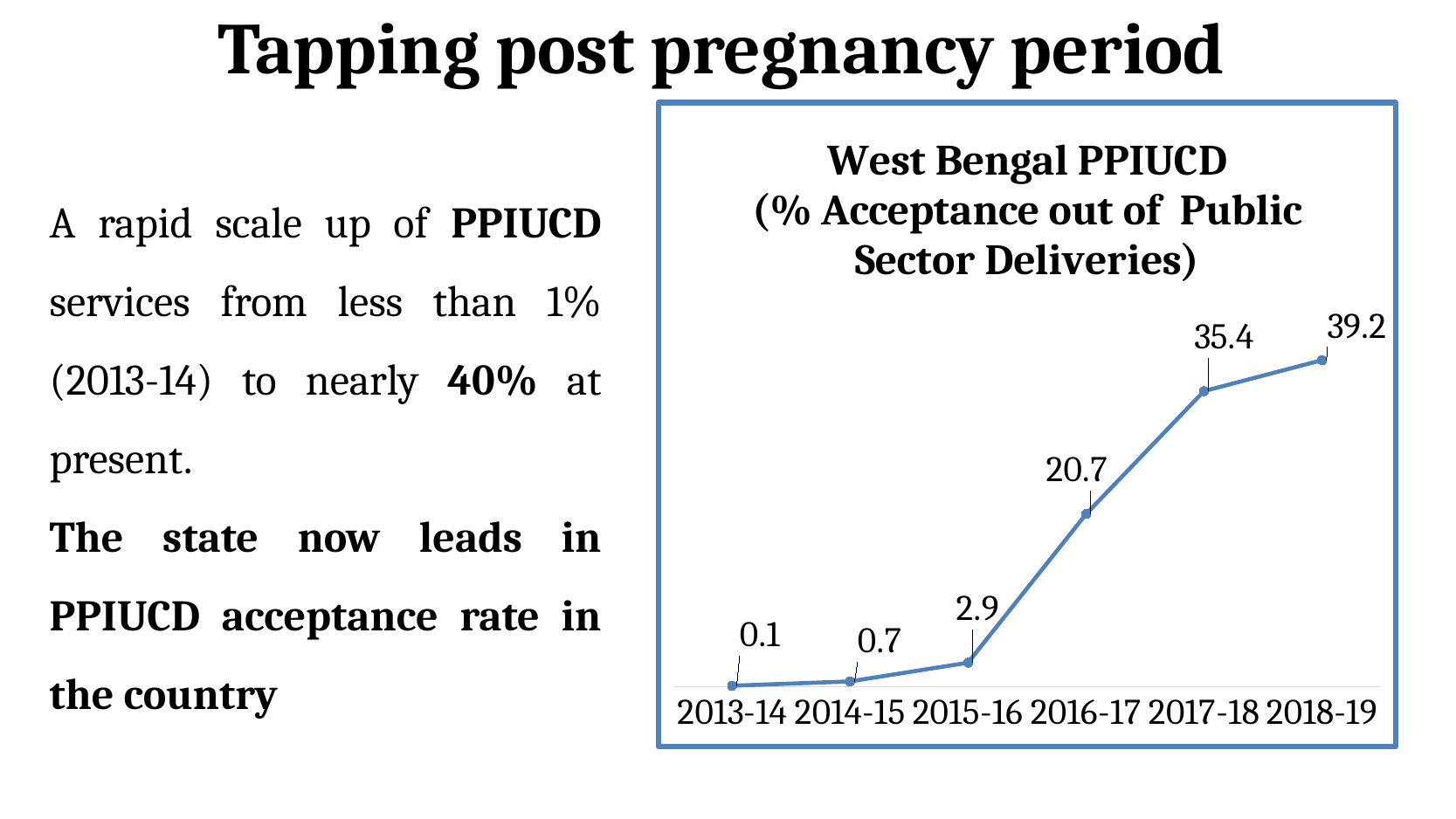
What is the PPIUCD acceptance value for 2013-14? 0.1 What is the PPIUCD acceptance value for 2016-17? 20.7 Which is larger, the value for 2017-18 or the value for 2018-19? 2018-19 Which year has the lowest PPIUCD acceptance value? 2013-14 Do the values rise or fall from 2013-14 to 2018-19? Rise Which year has the highest PPIUCD acceptance value? 2018-19 What is the PPIUCD acceptance value for 2018-19? 39.2 What is the title of the chart? West Bengal PPIUCD (% Acceptance out of Public Sector Deliveries) What is the difference between the values for 2015-16 and 2014-15? 2.2 What kind of chart is shown on the slide? Line chart What is the difference between the values for 2017-18 and 2016-17? 14.7 How many years are plotted on the chart? 6